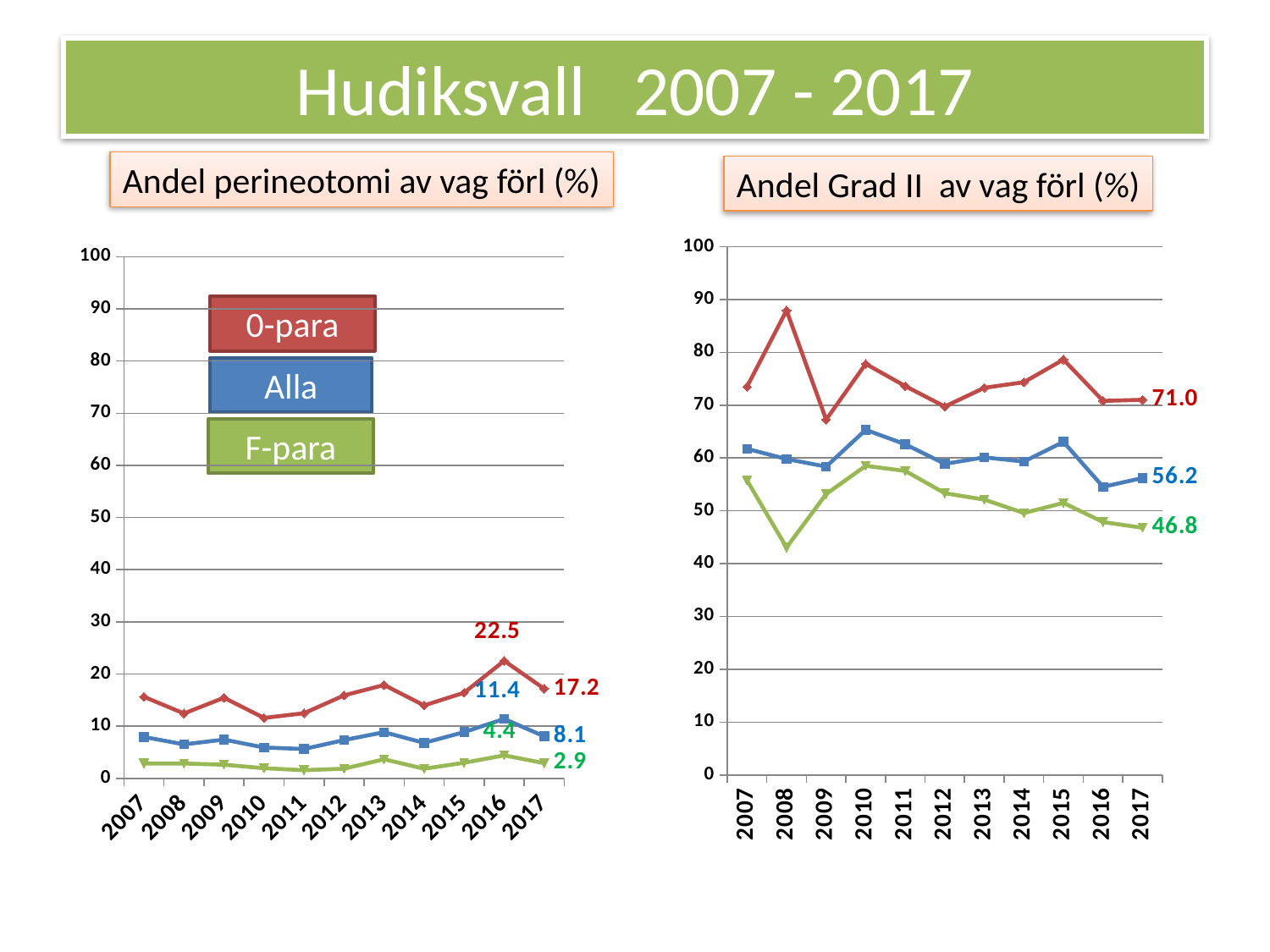
In the chart titled "Andel Grad II av vag förl (%)", is the value for the red line in 2008 greater or less than 80? greater What kind of chart is the chart titled "Andel Grad II av vag förl (%)"? Line chart In the chart titled "Andel perineotomi av vag förl (%)", how many series does the legend list? 3 In the chart titled "Andel perineotomi av vag förl (%)", what is the value for F-para in 2017? 2.9 In the chart titled "Andel perineotomi av vag förl (%)", what is the value for Alla in 2016? 11.4 In the chart titled "Andel perineotomi av vag förl (%)", what is the value for 0-para in 2017? 17.2 In the chart titled "Andel perineotomi av vag förl (%)", which series has the highest value in 2017? 0-para In the chart titled "Andel Grad II av vag förl (%)", what is the difference between the Alla value and the F-para value in 2017? 9.4 In the chart titled "Andel Grad II av vag förl (%)", what is the value for the blue Alla line in 2017? 56.2 In the chart titled "Andel perineotomi av vag förl (%)", what is the difference between the 0-para value in 2016 and in 2017? 5.3 In the chart titled "Andel Grad II av vag förl (%)", what is the value for the red 0-para line in 2017? 71.0 In the chart titled "Andel Grad II av vag förl (%)", how many years are shown on the x axis? 11